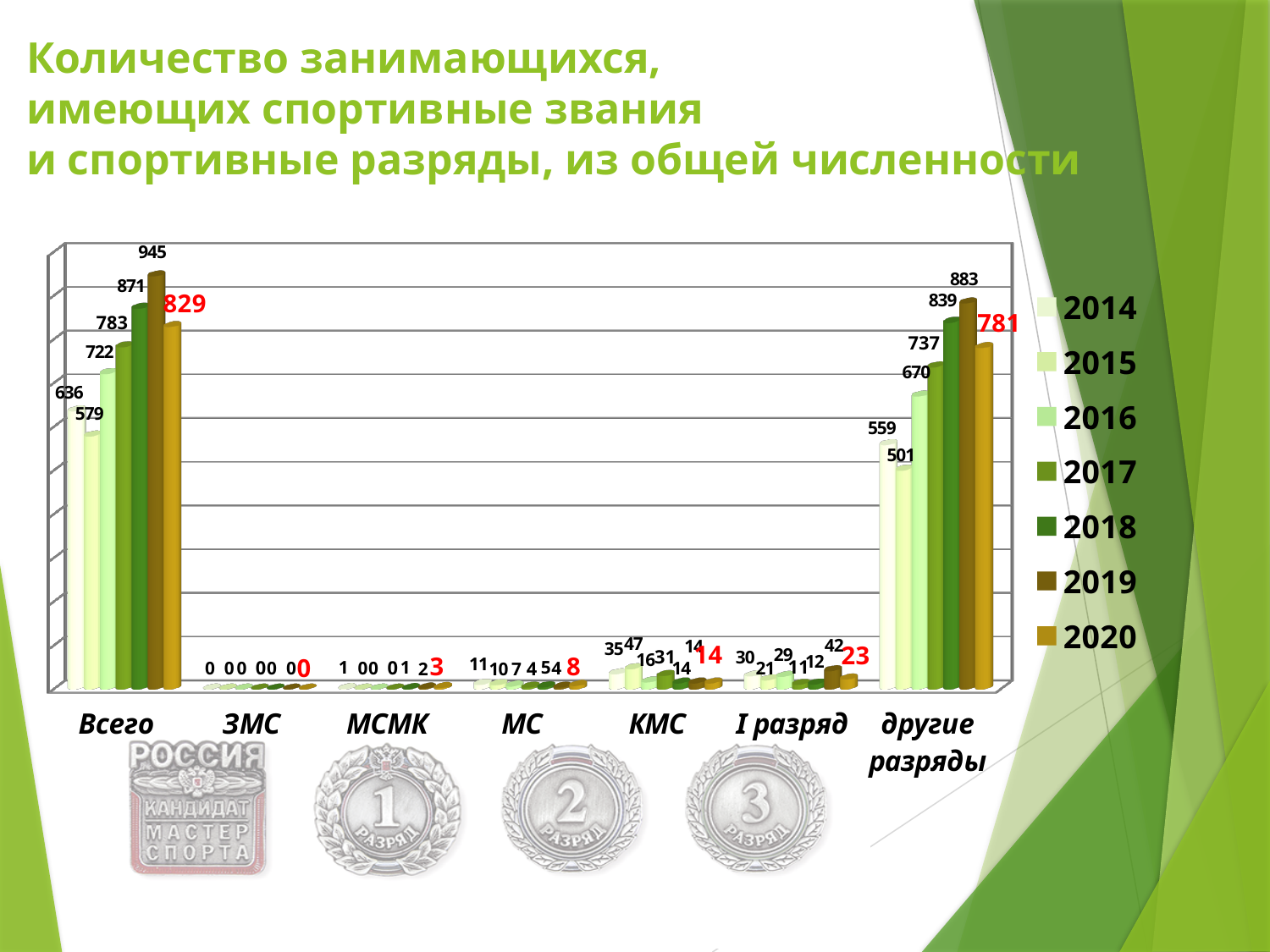
What is the value for Всего in 2019? 945 Which is larger for другие разряды: the 2016 value or the 2017 value? 2017 In which year is the value for Всего the lowest? 2015 What is the value for I разряд in 2019? 42 What kind of chart is shown on the slide? bar chart Do the values for Всего rise or fall from 2015 to 2019? rise What is the difference between the Всего values for 2019 and 2020? 116 How many series does the legend list? 7 What is the value for другие разряды in 2018? 839 In which year is the value for Всего the highest? 2019 What is the value for Всего in 2020? 829 How many categories are shown on the x axis? 7